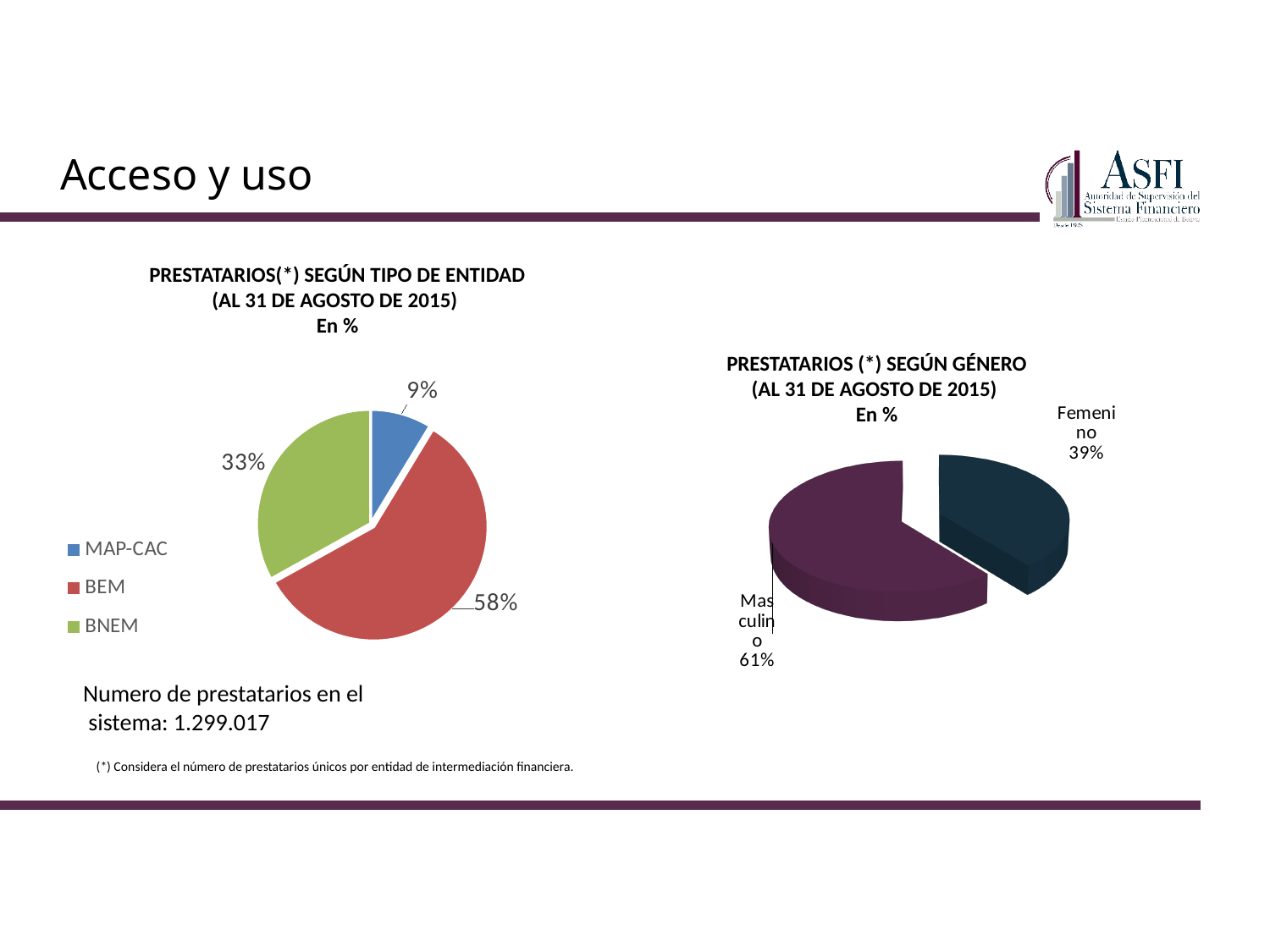
In the chart titled 'PRESTATARIOS (*) SEGÚN GÉNERO', which gender has the larger share, Masculino or Femenino? Masculino What kind of chart is the one titled 'PRESTATARIOS(*) SEGÚN TIPO DE ENTIDAD'? Pie chart In the chart titled 'PRESTATARIOS (*) SEGÚN GÉNERO', what share of borrowers is Femenino? 39% In the chart titled 'PRESTATARIOS (*) SEGÚN GÉNERO', what is the difference in percentage points between Masculino and Femenino? 22 In the chart titled 'PRESTATARIOS(*) SEGÚN TIPO DE ENTIDAD', what share of borrowers corresponds to MAP-CAC? 9% In the chart titled 'PRESTATARIOS(*) SEGÚN TIPO DE ENTIDAD', what share of borrowers corresponds to BEM? 58% In the chart titled 'PRESTATARIOS(*) SEGÚN TIPO DE ENTIDAD', which entity type has the smallest share? MAP-CAC In the chart titled 'PRESTATARIOS(*) SEGÚN TIPO DE ENTIDAD', what is the difference in percentage points between BEM and BNEM? 25 In the chart titled 'PRESTATARIOS (*) SEGÚN GÉNERO', what share of borrowers is Masculino? 61% In the chart titled 'PRESTATARIOS(*) SEGÚN TIPO DE ENTIDAD', which entity type has the largest share? BEM In the chart titled 'PRESTATARIOS(*) SEGÚN TIPO DE ENTIDAD', what share of borrowers corresponds to BNEM? 33% In the chart titled 'PRESTATARIOS(*) SEGÚN TIPO DE ENTIDAD', how many entity types are shown in the legend? 3